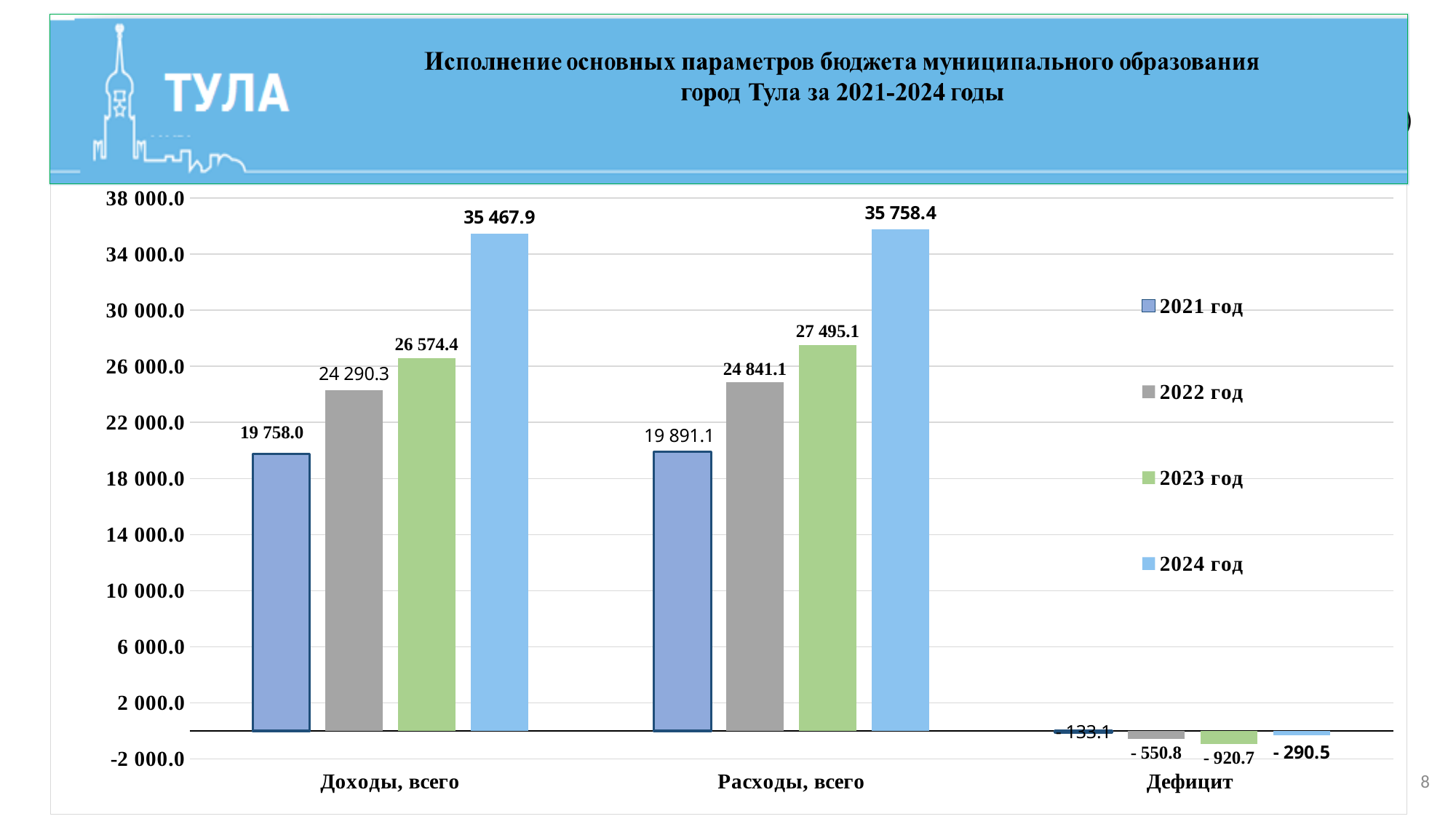
What is the value for 2021 год in the Доходы, всего category? 19 758.0 What is the difference between the 2024 год values for Расходы, всего and Доходы, всего? 290.5 What is the value for 2023 год in the Дефицит category? - 920.7 Is the 2022 год value for Доходы, всего greater or less than 26 000.0? less What is the value for 2022 год in the Расходы, всего category? 24 841.1 Which year has the lowest value in the Доходы, всего category? 2021 год How many series does the legend list? 4 What kind of chart is shown on the slide? bar chart Which is larger: the 2023 год value for Доходы, всего or the 2023 год value for Расходы, всего? Расходы, всего What is the value for 2024 год in the Доходы, всего category? 35 467.9 How many categories are shown on the x axis? 3 Which year has the highest value in the Расходы, всего category? 2024 год